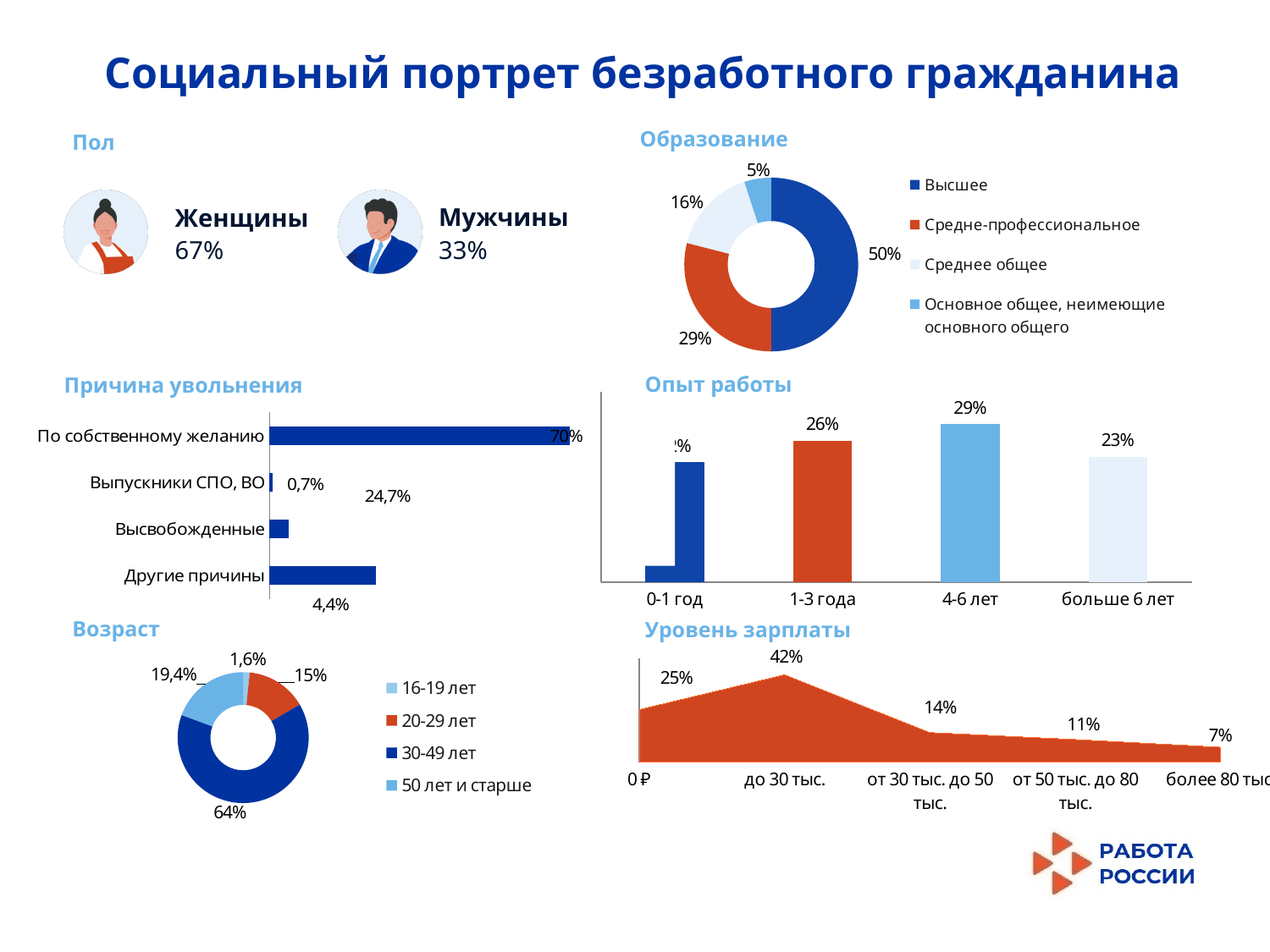
In the "Причина увольнения" chart, what is the value for По собственному желанию? 70% In the "Уровень зарплаты" chart, what is the value for до 30 тыс.? 42% What kind of chart is the "Причина увольнения" chart? Bar chart In the "Опыт работы" chart, what is the value for 4-6 лет? 29% In the "Возраст" chart, what share is labelled for 30-49 лет? 64% In the "Причина увольнения" chart, which category has the highest value? По собственному желанию In the "Образование" chart, what share is labelled for Высшее? 50% How many entries does the legend of the "Образование" chart list? 4 In the "Уровень зарплаты" chart, how many categories are shown on the x axis? 5 In the "Возраст" chart, which is larger: 20-29 лет or 50 лет и старше? 50 лет и старше In the "Опыт работы" chart, what is the difference between 4-6 лет and больше 6 лет? 6% In the "Образование" chart, which category has the smallest share? Основное общее, неимеющие основного общего